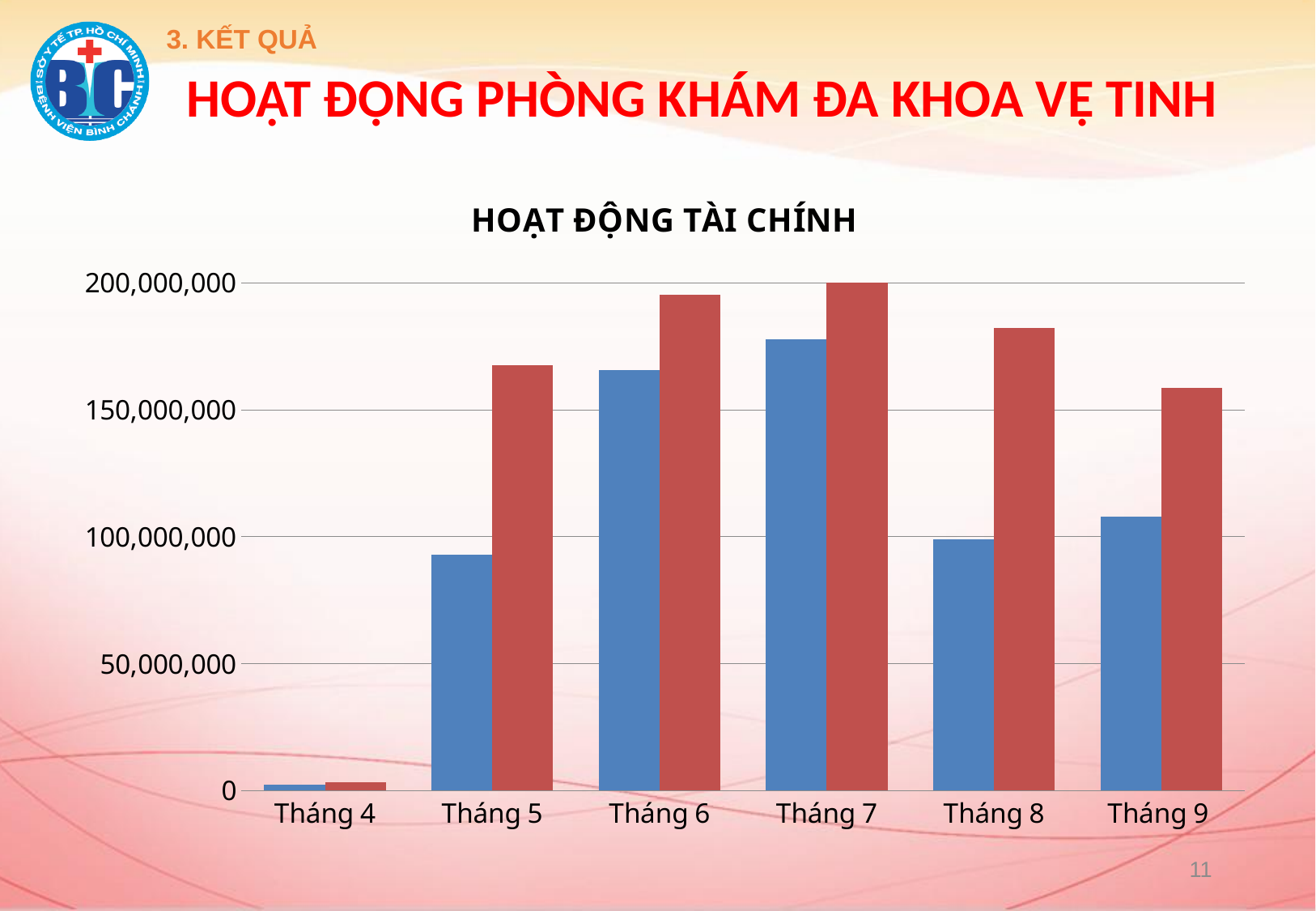
Which month has the lowest red bar? Tháng 4 Is the red bar for Tháng 5 greater or less than 150,000,000? greater Do the blue bars rise or fall from Tháng 4 to Tháng 7? rise Is the blue bar for Tháng 5 greater or less than 100,000,000? less What kind of chart is shown on the slide? bar chart How many bars are plotted for each month in the chart? 2 Which month has the tallest blue bar? Tháng 7 Which month has the tallest red bar? Tháng 7 Is the blue bar for Tháng 6 greater or less than 150,000,000? greater In Tháng 8, which bar is larger, the blue bar or the red bar? the red bar How many categories (months) are shown on the x axis of the chart? 6 What is the title of the chart? HOẠT ĐỘNG TÀI CHÍNH